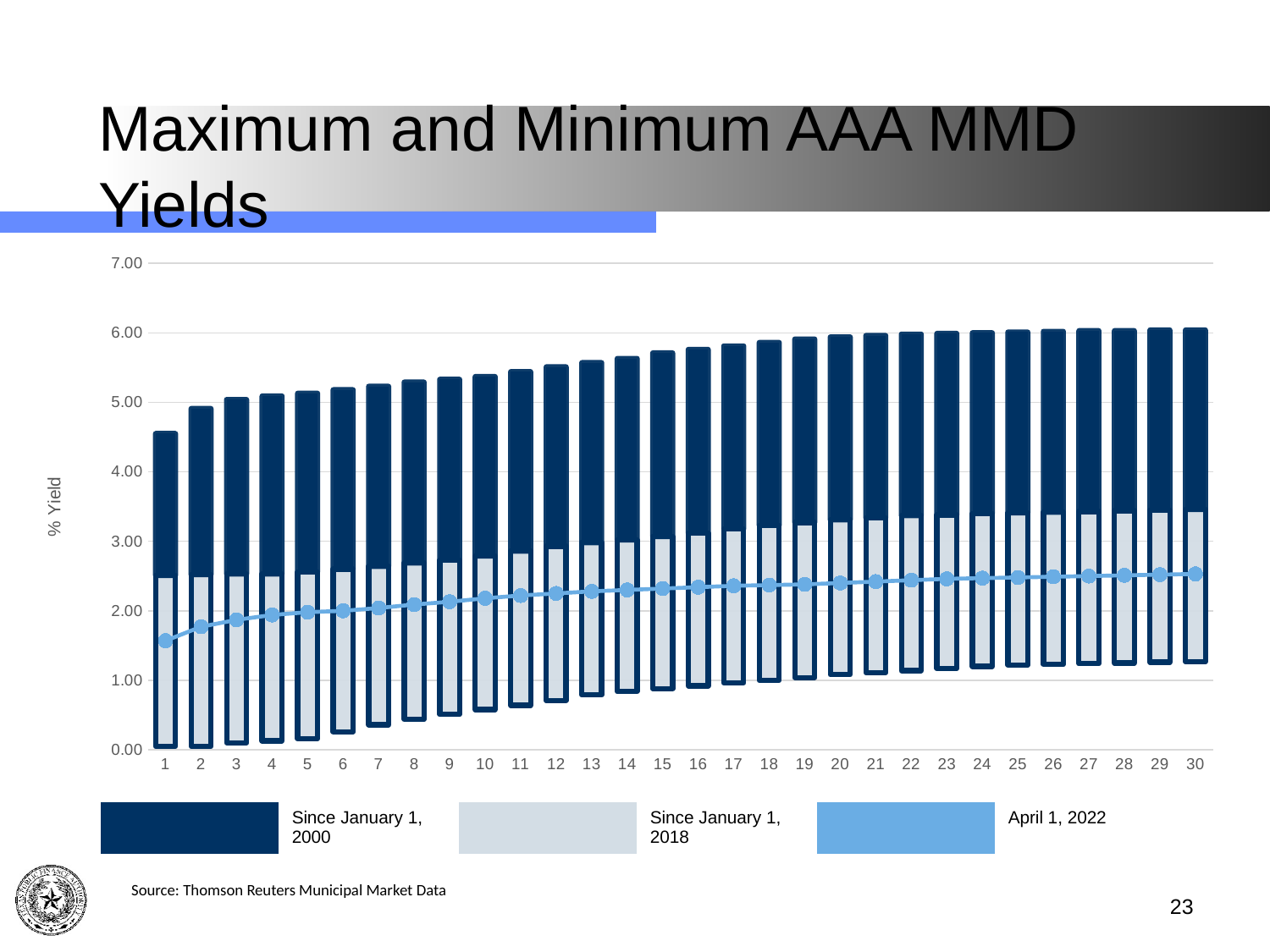
Is the top of the Since January 1, 2000 bar for category 1 greater or less than 5.00? less What is the label on the y axis of the chart? % Yield Is the April 1, 2022 value for category 30 greater or less than 3.00? less What kind of chart is shown on the slide? bar chart with a line Is the April 1, 2022 value for category 15 greater or less than 2.00? greater Which category has the lowest April 1, 2022 value? 1 How many categories are shown along the x axis of the chart? 30 Does the April 1, 2022 line rise or fall as the categories increase from 1 to 30? rise How many series does the chart's legend list? 3 What are the three legend entries of the chart? Since January 1, 2000; Since January 1, 2018; April 1, 2022